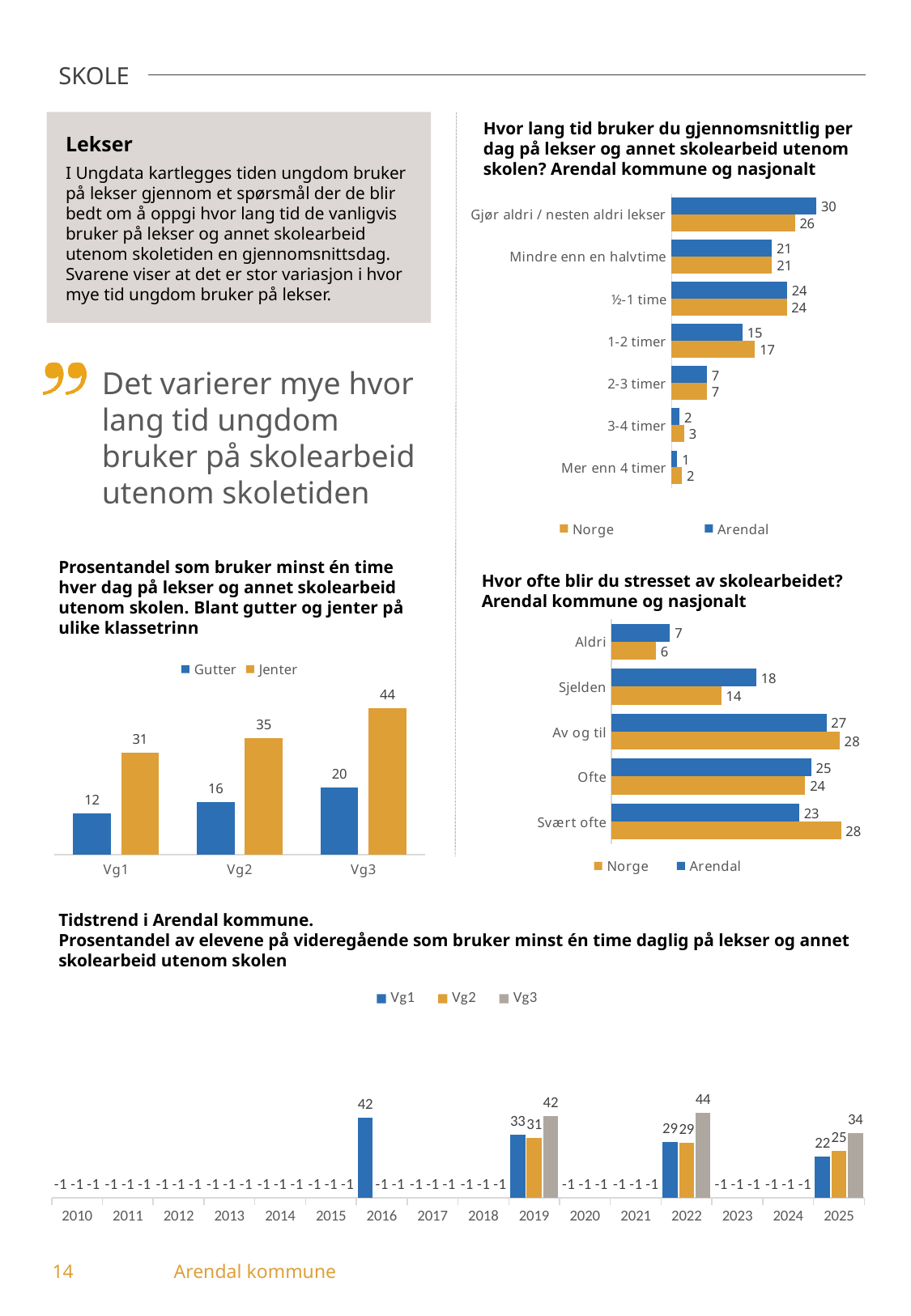
In the chart 'Tidstrend i Arendal kommune', what is the Vg3 value for 2022? 44 In the chart 'Prosentandel som bruker minst én time hver dag på lekser og annet skolearbeid utenom skolen', which series has the higher value at Vg1, Gutter or Jenter? Jenter In the chart 'Hvor lang tid bruker du gjennomsnittlig per dag på lekser og annet skolearbeid utenom skolen?', what is the Arendal value for 'Gjør aldri / nesten aldri lekser'? 30 In the chart 'Hvor ofte blir du stresset av skolearbeidet?', what is the Norge value for 'Svært ofte'? 28 In the chart 'Hvor lang tid bruker du gjennomsnittlig per dag på lekser og annet skolearbeid utenom skolen?', what is the Norge value for '1-2 timer'? 17 In the chart 'Prosentandel som bruker minst én time hver dag på lekser og annet skolearbeid utenom skolen', what is the value for Jenter at Vg3? 44 In the chart 'Hvor ofte blir du stresset av skolearbeidet?', which category has the lowest Norge value? Aldri In the chart 'Hvor lang tid bruker du gjennomsnittlig per dag på lekser og annet skolearbeid utenom skolen?', what is the difference between the Arendal and Norge values for 'Gjør aldri / nesten aldri lekser'? 4 In the chart 'Hvor ofte blir du stresset av skolearbeidet?', what kind of chart is it? bar chart In the chart 'Tidstrend i Arendal kommune', how many series does the legend list? 3 In the chart 'Hvor lang tid bruker du gjennomsnittlig per dag på lekser og annet skolearbeid utenom skolen?', how many categories are shown? 7 In the chart 'Prosentandel som bruker minst én time hver dag på lekser og annet skolearbeid utenom skolen', do the Gutter values rise or fall from Vg1 to Vg3? rise